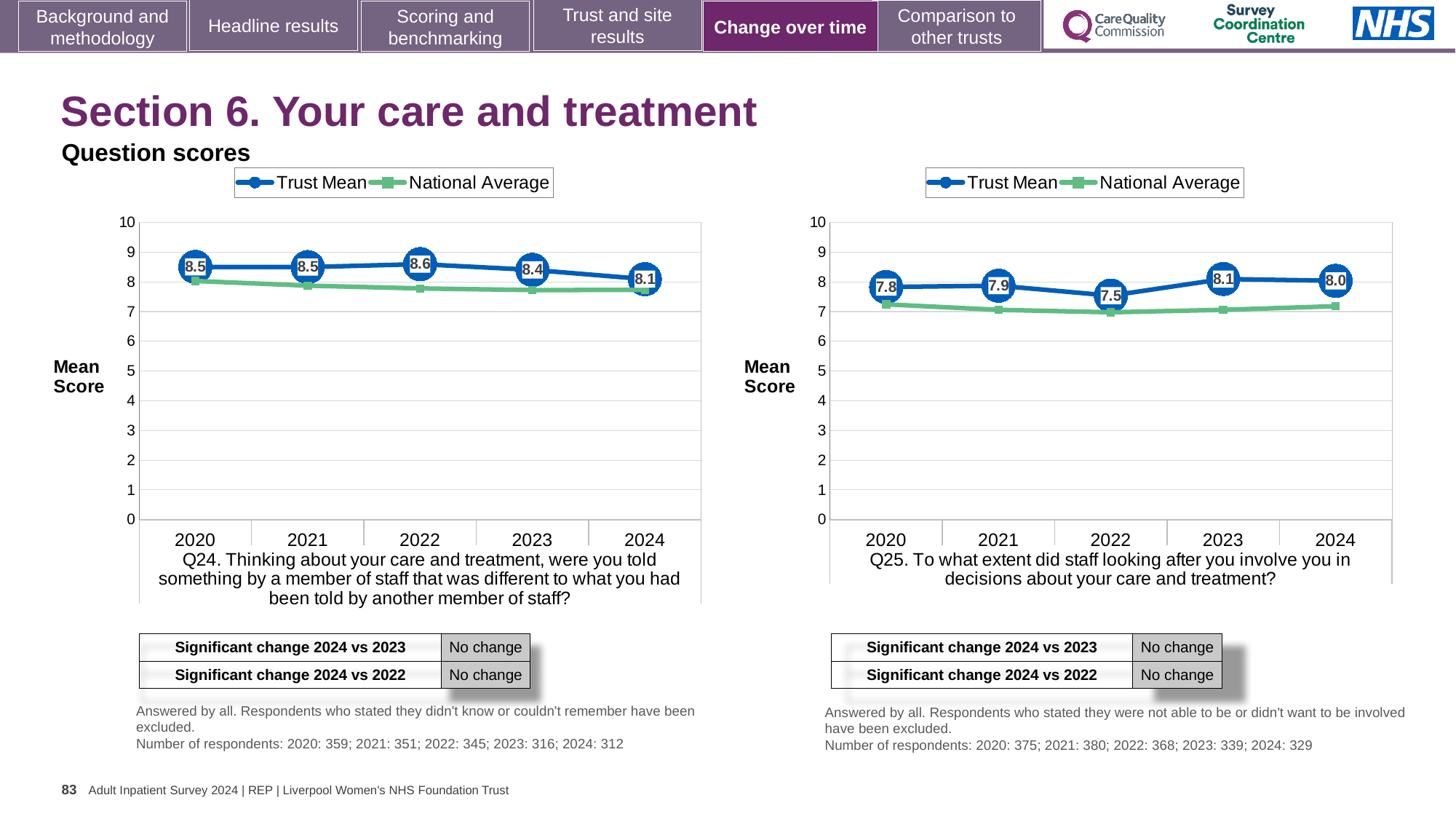
In the Q24 chart (left), what is the difference between the Trust Mean scores for 2022 and 2024? 0.5 In the Q25 chart (right), what is the Trust Mean score for 2022? 7.5 In the Q25 chart (right), what is the Trust Mean score for 2023? 8.1 In the Q24 chart (left), what is the Trust Mean score for 2024? 8.1 In the Q25 chart (right), is the Trust Mean score for 2020 or for 2023 higher? 2023 In the Q24 chart (left), what is the Trust Mean score for 2022? 8.6 In the Q25 chart (right), is the National Average for 2022 greater or less than 8? less What kind of chart is the Q25 chart (right)? Line chart How many series does the legend of the Q24 chart (left) list? 2 In the Q25 chart (right), what is the difference between the Trust Mean scores for 2023 and 2022? 0.6 In the Q24 chart (left), which year has the highest Trust Mean score? 2022 In the Q25 chart (right), which year has the lowest Trust Mean score? 2022